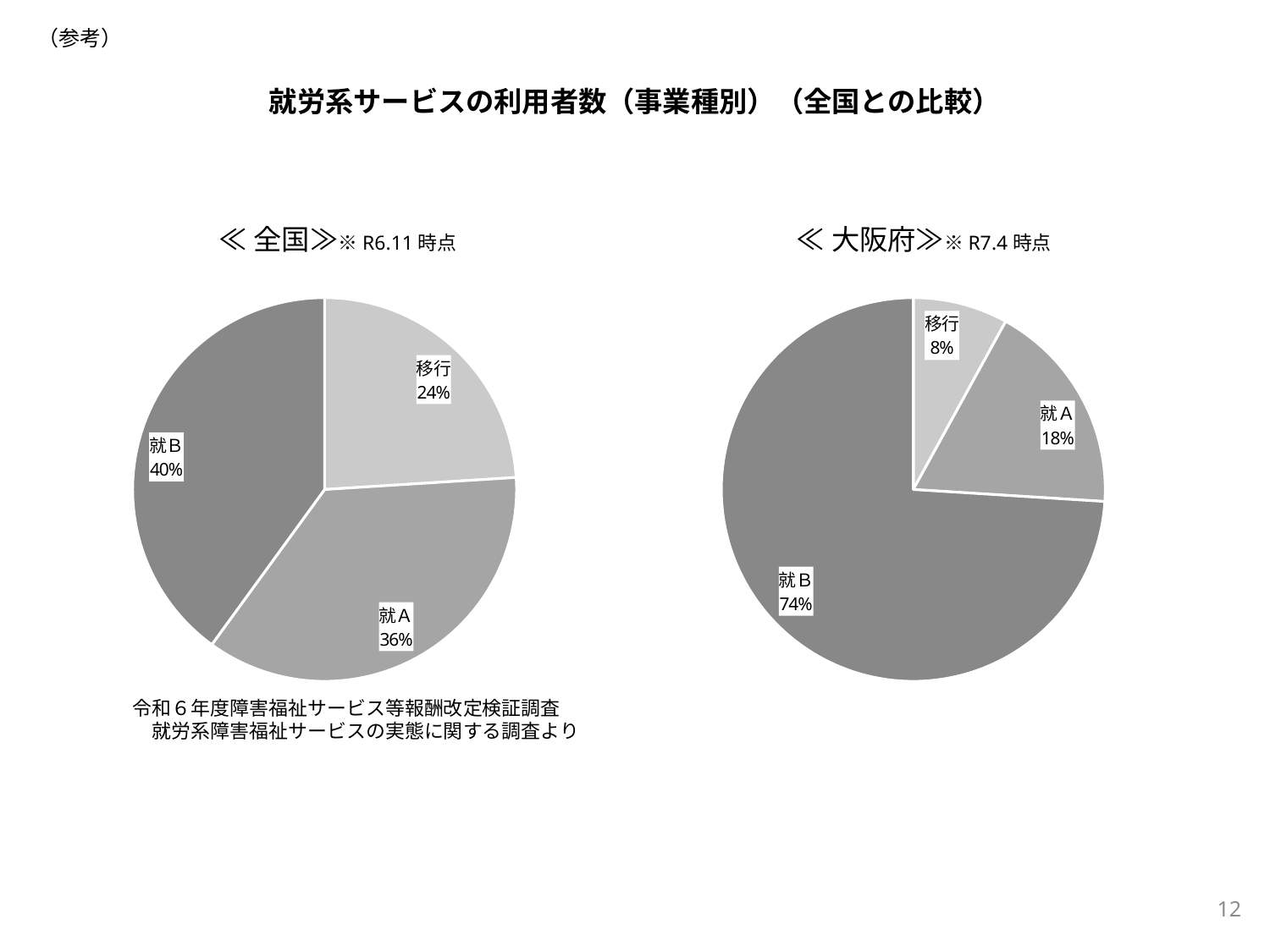
In the 大阪府 pie chart, what share does 就B have? 74% How many categories does the 大阪府 pie chart show? 3 In the 全国 pie chart, what is the difference in percentage points between 就B and 就A? 4 In the 大阪府 pie chart, which category has the largest share? 就B Which is larger: the 移行 share in the 全国 chart or the 移行 share in the 大阪府 chart? 全国 In the 全国 pie chart, what share does 移行 have? 24% In the 全国 pie chart, what share does 就B have? 40% In the 大阪府 pie chart, which category has the smallest share? 移行 In the 全国 pie chart, which category has the smallest share? 移行 What type of chart is used for the 全国 data? Pie chart In the 大阪府 pie chart, what share does 就A have? 18% What is the difference in percentage points between the 就B share in the 大阪府 chart and the 就B share in the 全国 chart? 34